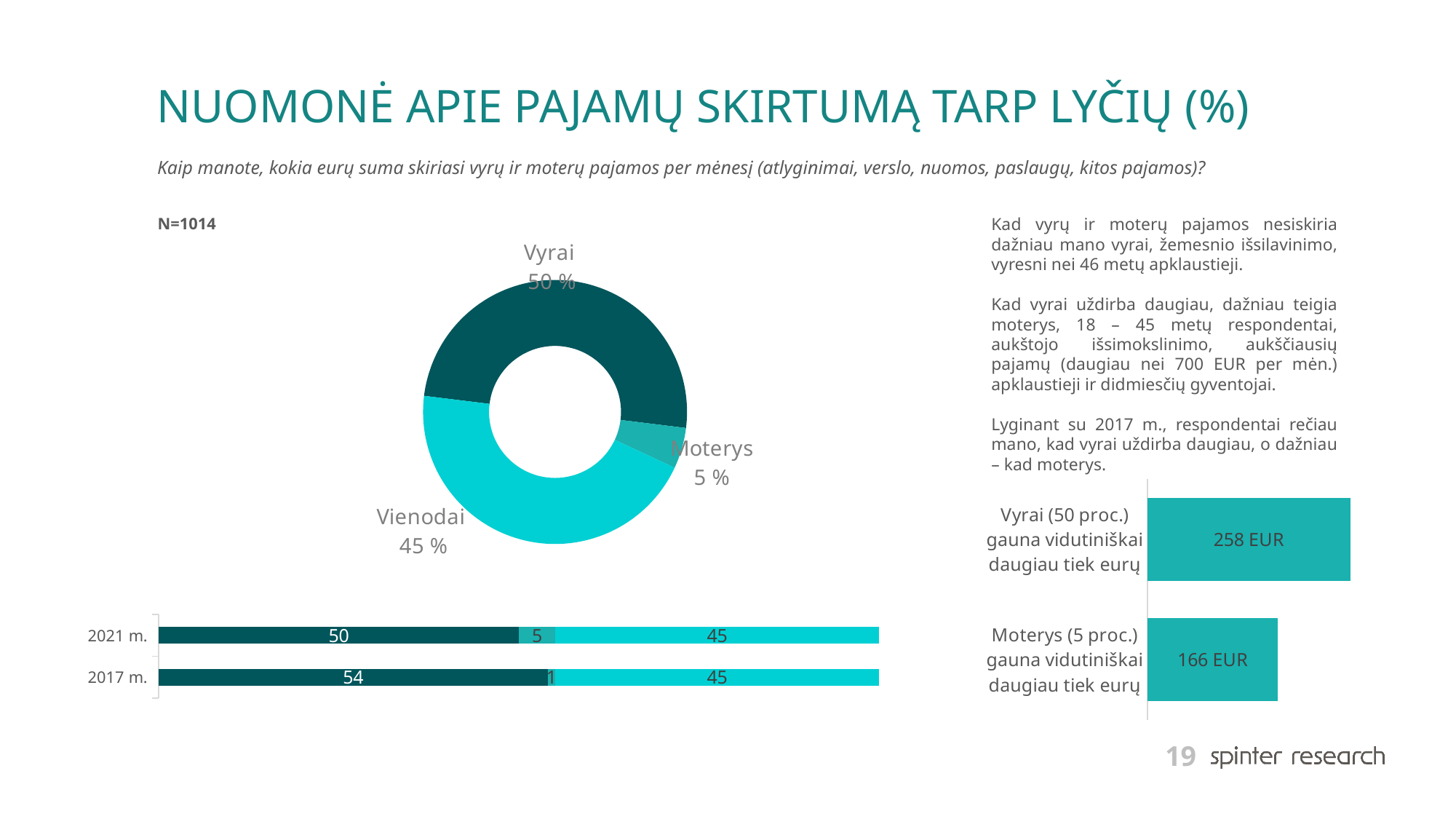
In the stacked bar chart at the bottom, what is the value of the middle segment for 2017 m.? 1 In the donut chart, which category has the smallest share? Moterys In the stacked bar chart at the bottom, what is the value of the first (dark) segment for 2017 m.? 54 In the donut chart, which category has the largest share? Vyrai In the bar chart on the right, what is the difference between the Vyrai value and the Moterys value? 92 EUR In the bar chart on the right, what is the value for "Vyrai (50 proc.) gauna vidutiniškai daugiau tiek eurų"? 258 EUR In the donut chart, what share of respondents answered "Vyrai"? 50 % In the stacked bar chart at the bottom, what is the total of the 2021 m. bar? 100 In the donut chart, how many categories are shown? 3 What type of chart is shown on the right side of the slide with the EUR values? Bar chart In the stacked bar chart at the bottom, what is the difference between the first segment for 2017 m. and the first segment for 2021 m.? 4 In the donut chart, what share of respondents answered "Moterys"? 5 %